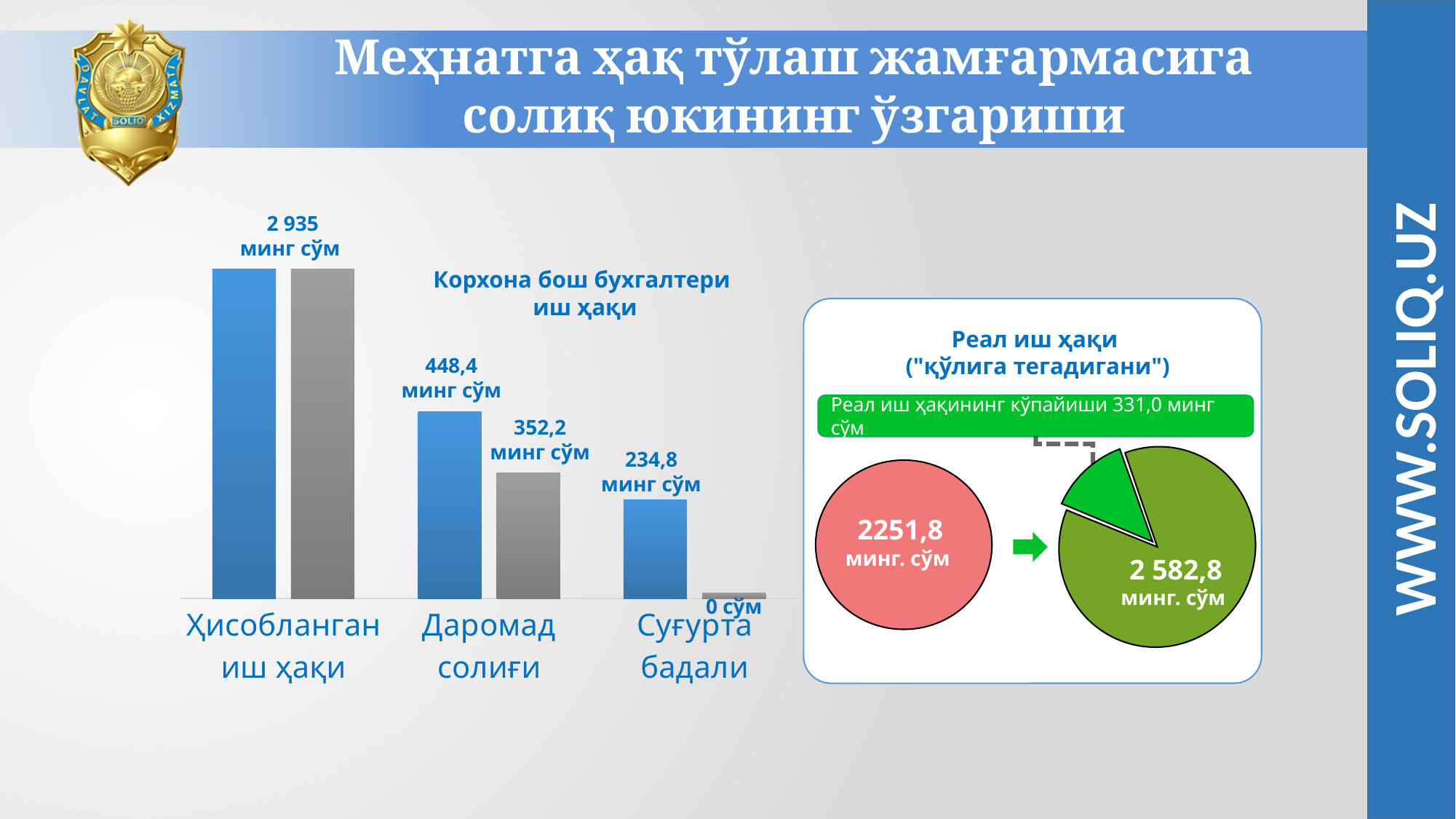
In the bar chart "Корхона бош бухгалтери иш ҳақи", what value is labelled for the gray bar of "Даромад солиғи"? 352,2 минг сўм In the "Реал иш ҳақи" panel on the right, what value is printed inside the pink circle? 2251,8 минг. сўм In the bar chart "Корхона бош бухгалтери иш ҳақи", what value is labelled for the gray bar of "Суғурта бадали"? 0 сўм In the bar chart "Корхона бош бухгалтери иш ҳақи", for "Суғурта бадали", which bar is larger, the blue or the gray one? blue In the bar chart "Корхона бош бухгалтери иш ҳақи", what is the difference between the blue and gray bars for "Даромад солиғи"? 96,2 минг сўм In the bar chart "Корхона бош бухгалтери иш ҳақи", what value is labelled for the blue bar of "Суғурта бадали"? 234,8 минг сўм How many categories are shown on the x axis of the bar chart "Корхона бош бухгалтери иш ҳақи"? 3 In the "Реал иш ҳақи" panel on the right, what value is printed inside the green pie chart? 2 582,8 минг. сўм In the bar chart "Корхона бош бухгалтери иш ҳақи", what value is labelled for the blue bar of "Даромад солиғи"? 448,4 минг сўм What kind of chart is the chart titled "Корхона бош бухгалтери иш ҳақи"? bar chart In the bar chart "Корхона бош бухгалтери иш ҳақи", what value is labelled above the bars for "Ҳисобланган иш ҳақи"? 2 935 минг сўм In the bar chart "Корхона бош бухгалтери иш ҳақи", which category has the tallest bars? Ҳисобланган иш ҳақи